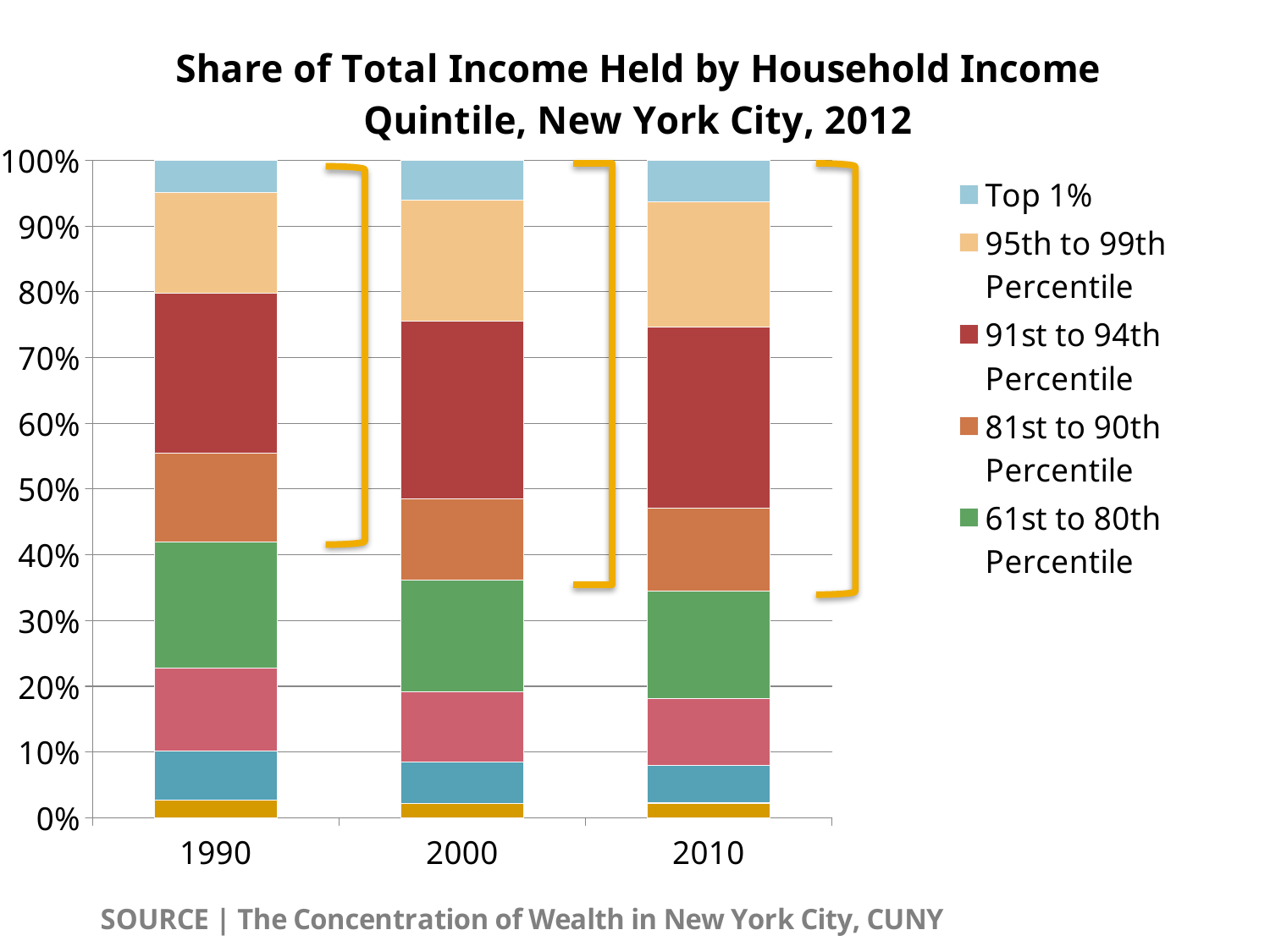
In the 2000 bar, is the top of the 81st to 90th Percentile segment greater or less than 40%? greater In the 2010 bar, is the top of the 61st to 80th Percentile segment greater or less than 40%? less Does the cumulative share held by the bottom segments up to the 61st to 80th Percentile rise or fall from 1990 to 2010? fall How many years (bars) are shown on the x axis? 3 What is the title of the chart? Share of Total Income Held by Household Income Quintile, New York City, 2012 How many series does the legend list? 5 In the 2010 bar, is the top of the 91st to 94th Percentile segment greater or less than 80%? less Which year has the lowest top boundary for the 61st to 80th Percentile segment? 2010 Is the Top 1% segment larger in 1990 or in 2010? 2010 Which series is listed first in the legend? Top 1% What kind of chart is shown on the slide? Stacked bar chart